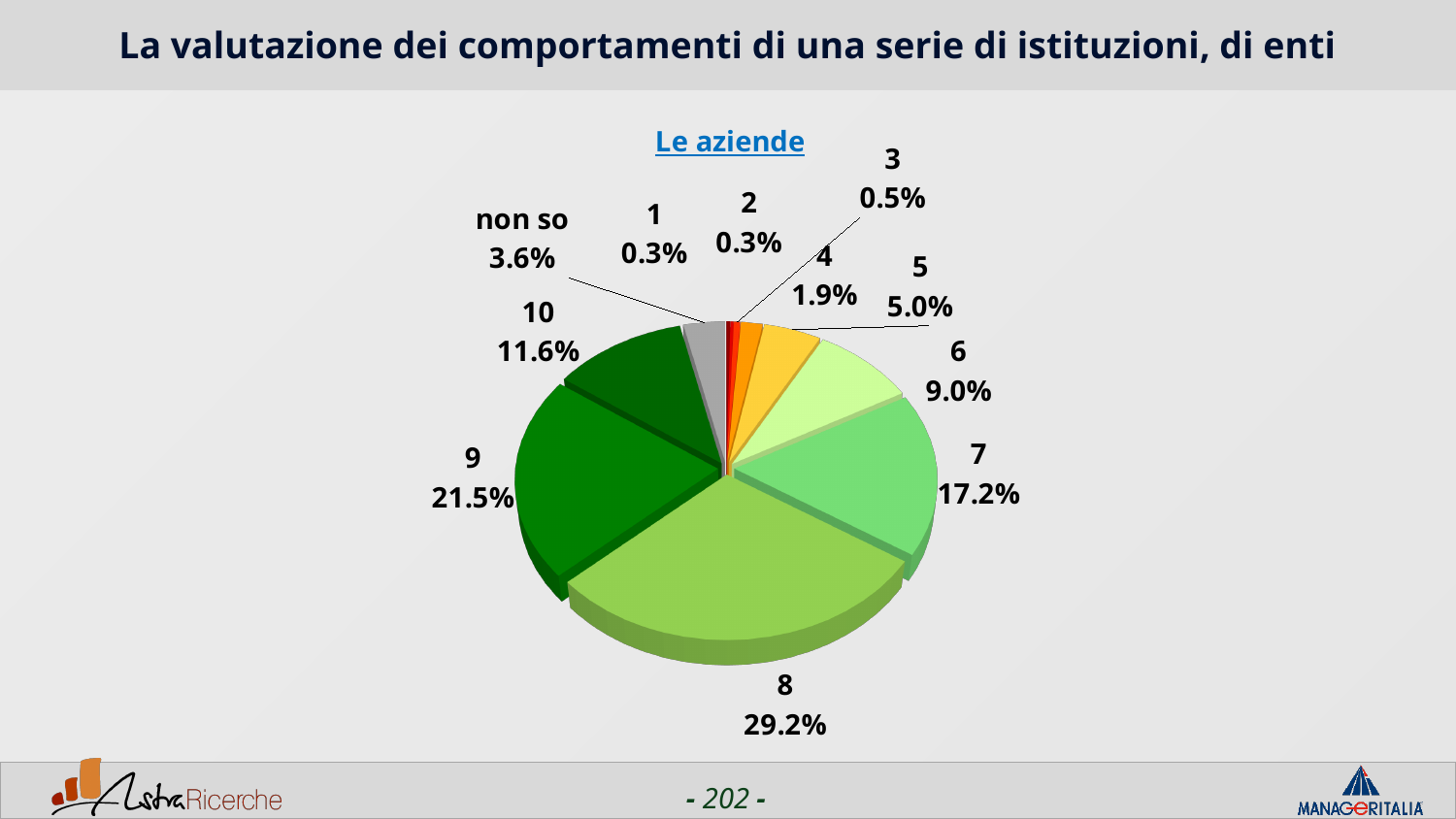
Which is larger, the share for category 10 or the share for category 6? 10 What is the difference between the shares of category 8 and category 9? 7.7% What is the title of the chart? Le aziende What percentage is shown for category 8? 29.2% Which category has the largest share of the pie? 8 What percentage is shown for category 4? 1.9% What type of chart is shown on the slide? pie chart What is the combined share of categories 1, 2 and 3? 1.1% What percentage is shown for category 9? 21.5% How many slices does the pie chart have? 11 What percentage is shown for 'non so'? 3.6% Which category has the largest share among 5, 6 and 7? 7